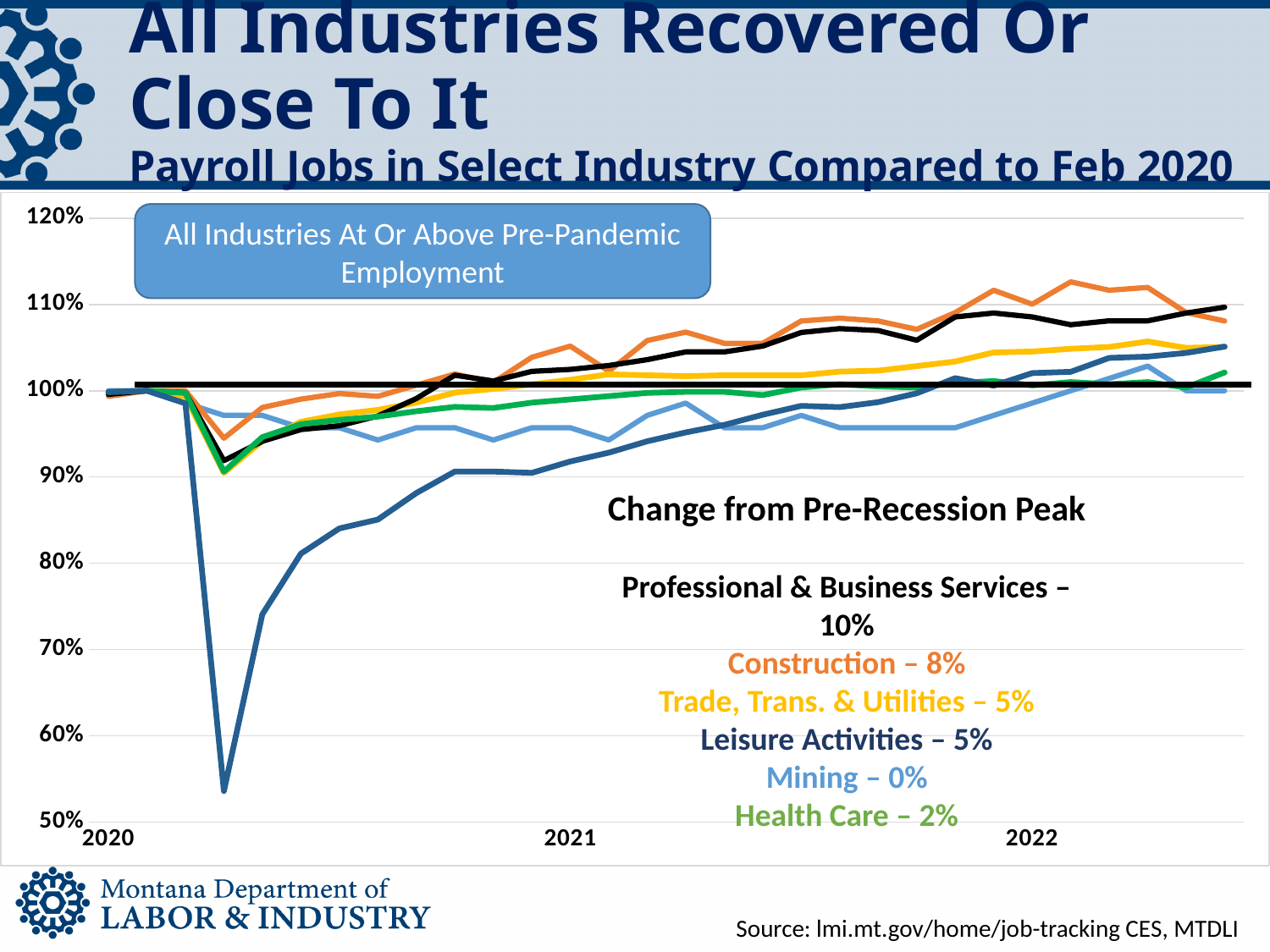
What kind of chart is shown on the slide? Line chart Does the Leisure Activities line rise or fall between 2021 and 2022? Rise What is the change from pre-recession peak for Professional & Business Services? 10% What is the difference between the change from pre-recession peak for Construction and for Health Care? 6 percentage points Which industry has the smallest change from pre-recession peak? Mining Is the lowest point of the Leisure Activities line in 2020 greater or less than 60%? less Which industry has the largest change from pre-recession peak? Professional & Business Services How many industry series are listed in the 'Change from Pre-Recession Peak' annotation? 6 What is the change from pre-recession peak for Construction? 8% What is the change from pre-recession peak for Mining? 0% What is the title of the chart? Payroll Jobs in Select Industry Compared to Feb 2020 Which has a larger change from pre-recession peak, Construction or Trade, Trans. & Utilities? Construction